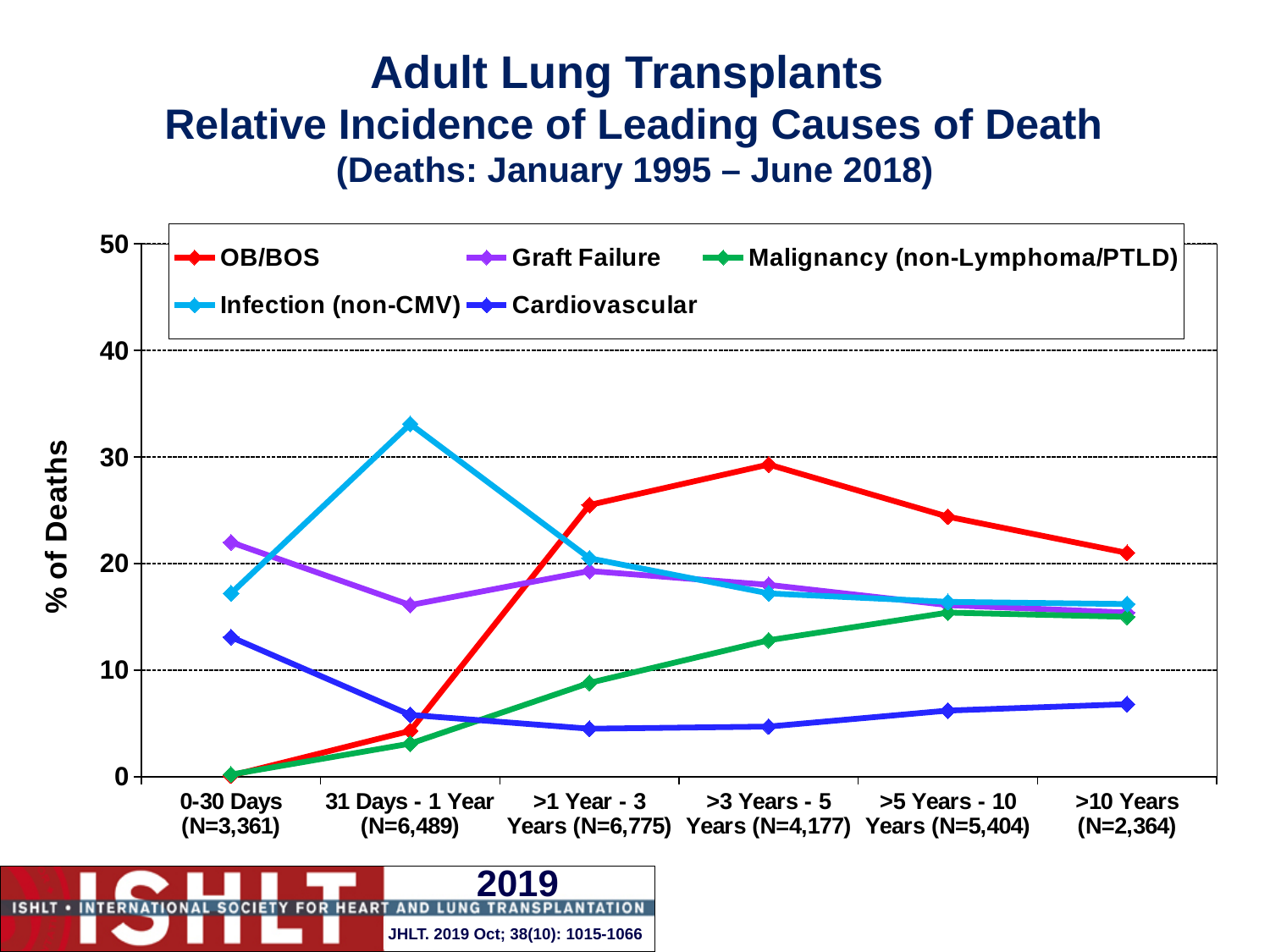
Is the value for Cardiovascular in the >1 Year - 3 Years period greater or less than 10? less Is the value for Infection (non-CMV) in the 31 Days - 1 Year period greater or less than 30? greater In the 0-30 Days period, which is larger: Graft Failure or Cardiovascular? Graft Failure What kind of chart is shown on the slide? Line chart Which cause of death has the highest % of deaths in the 31 Days - 1 Year period? Infection (non-CMV) Which cause of death has the highest % of deaths in the 0-30 Days period? Graft Failure Which cause of death has the lowest % of deaths in the >10 Years period? Cardiovascular Which cause of death has the highest % of deaths in the >3 Years - 5 Years period? OB/BOS What is the label on the y axis? % of Deaths How many time-period categories are shown on the x axis? 6 How many series does the legend list? 5 Does the OB/BOS line rise or fall from the >3 Years - 5 Years period to the >10 Years period? Fall